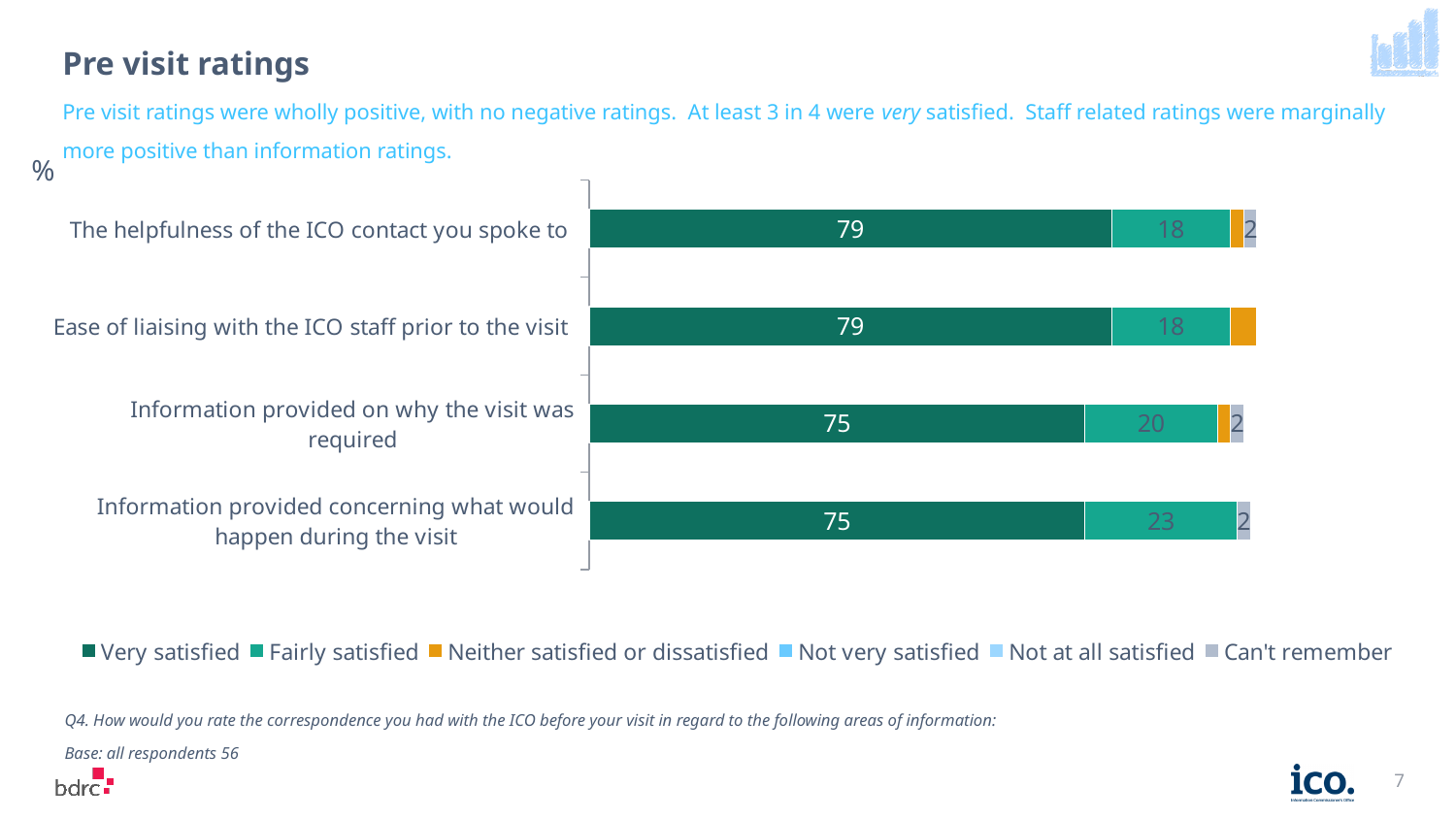
How many series does the legend list? 6 What is the Fairly satisfied value for 'Ease of liaising with the ICO staff prior to the visit'? 18 What is the Very satisfied value for 'Information provided on why the visit was required'? 75 What is the difference between the Very satisfied values for 'The helpfulness of the ICO contact you spoke to' and 'Information provided on why the visit was required'? 4 What is the Very satisfied value for 'The helpfulness of the ICO contact you spoke to'? 79 Which has the larger Very satisfied value: 'Ease of liaising with the ICO staff prior to the visit' or 'Information provided concerning what would happen during the visit'? Ease of liaising with the ICO staff prior to the visit Which category has the highest Fairly satisfied value? Information provided concerning what would happen during the visit How many categories are shown in the chart? 4 What is the difference between the Fairly satisfied values for 'Information provided concerning what would happen during the visit' and 'Ease of liaising with the ICO staff prior to the visit'? 5 What kind of chart is shown on the slide? Stacked bar chart What is the title of the slide? Pre visit ratings What is the Fairly satisfied value for 'Information provided concerning what would happen during the visit'? 23